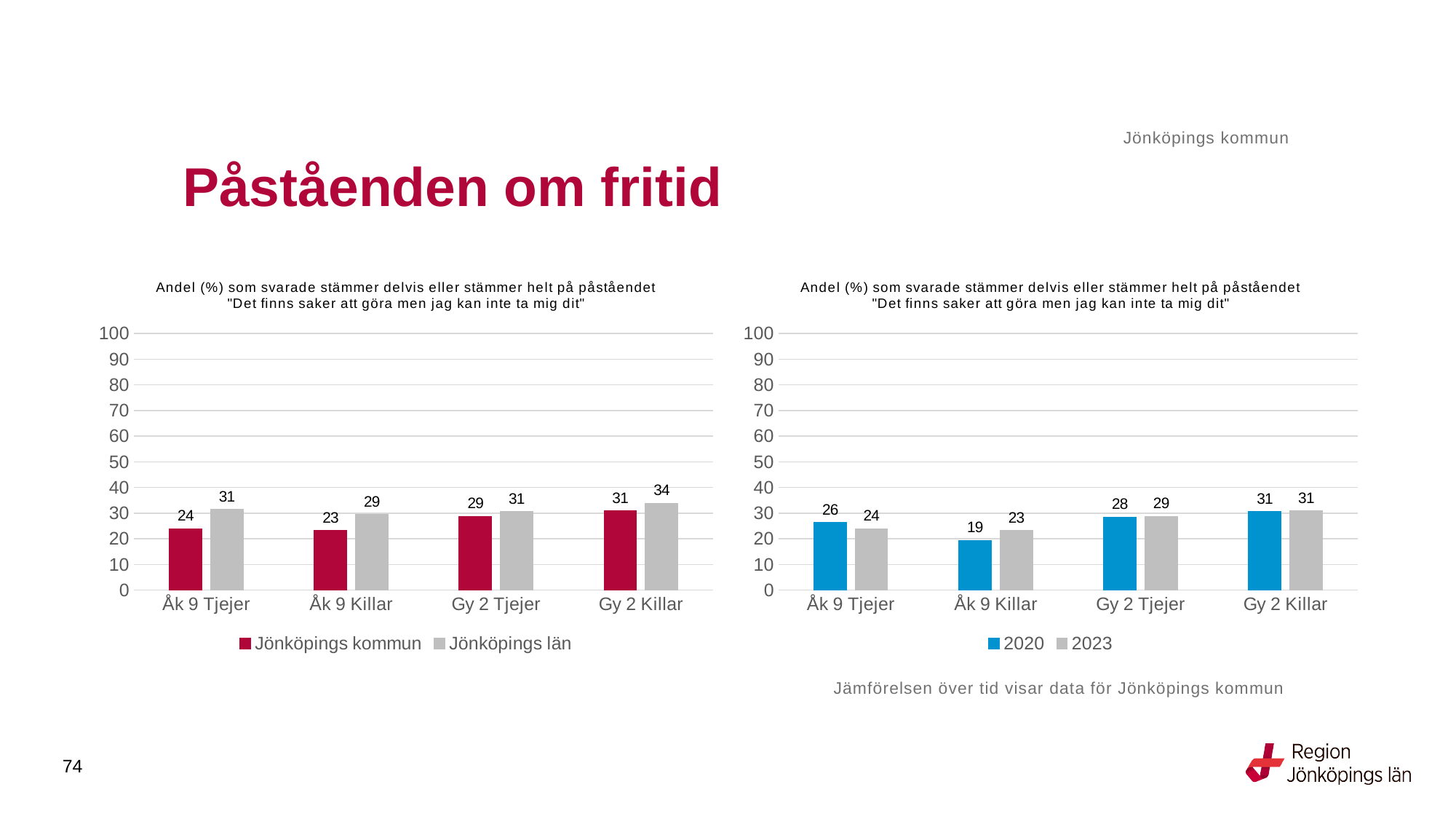
In the right chart, what is the value for 2020 for Åk 9 Killar? 19 In the right chart, which category has the highest value for 2020? Gy 2 Killar In the left chart, which category has the highest value for Jönköpings län? Gy 2 Killar What kind of chart is the right chart? bar chart In the left chart, what is the value for Jönköpings län for Gy 2 Killar? 34 In the right chart, what is the difference between the 2023 and 2020 values for Åk 9 Killar? 4 In the left chart, which category has the lowest value for Jönköpings kommun? Åk 9 Killar In the right chart, is the 2020 value for Åk 9 Tjejer larger or smaller than the 2023 value? larger In the left chart, what is the difference between Jönköpings län and Jönköpings kommun for Åk 9 Tjejer? 7 In the left chart, what is the value for Jönköpings kommun for Åk 9 Tjejer? 24 In the left chart, how many series does the legend list? 2 In the right chart, what is the value for 2023 for Gy 2 Tjejer? 29